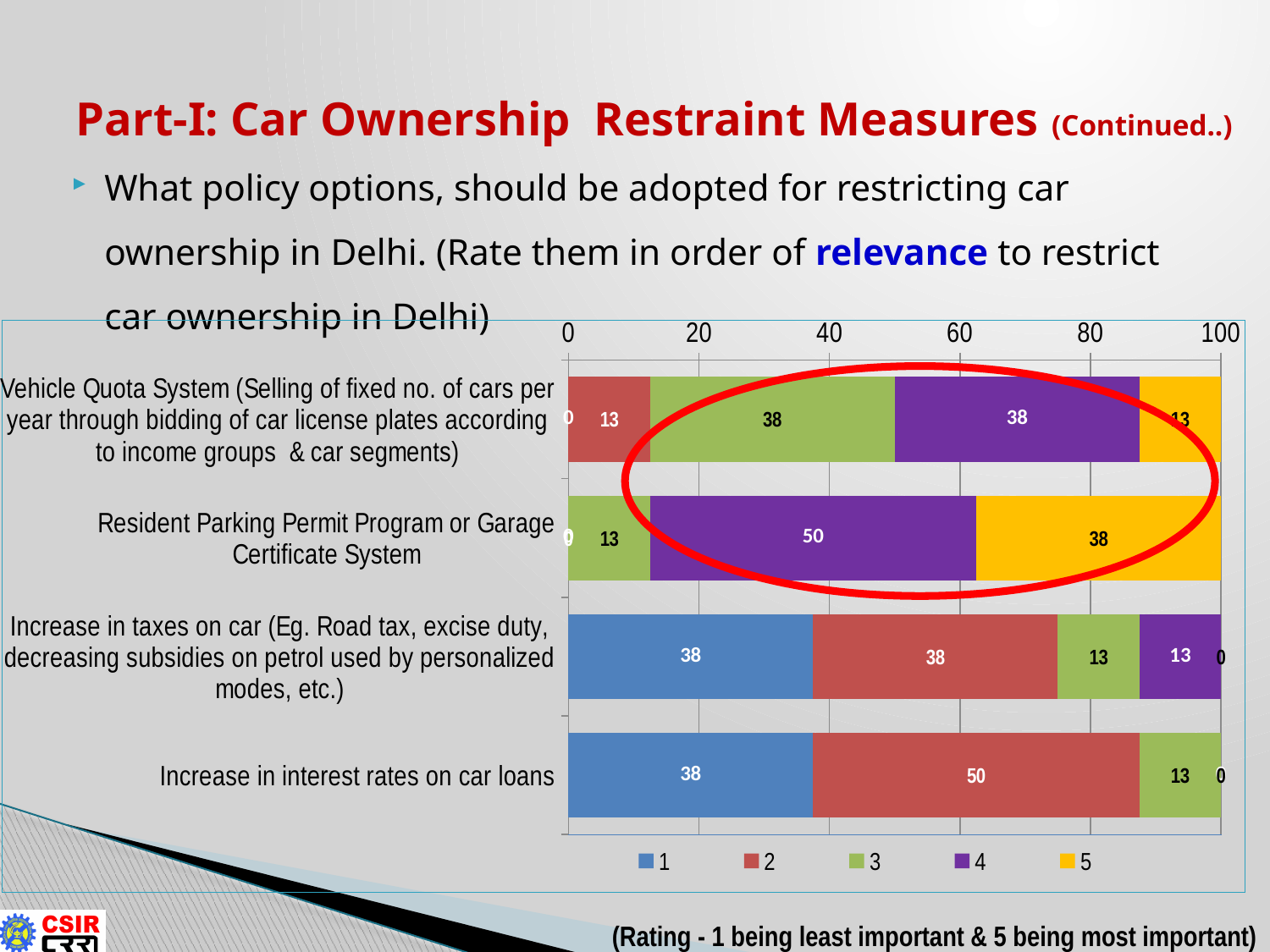
What is the value for rating 2 for 'Increase in interest rates on car loans'? 50 For 'Increase in interest rates on car loans', which is larger: the value for rating 1 or rating 2? rating 2 What is the difference between the rating 4 value and the rating 3 value for 'Resident Parking Permit Program or Garage Certificate System'? 37 Which colour represents rating 5 in the legend? yellow What is the value for rating 4 for 'Resident Parking Permit Program or Garage Certificate System'? 50 What kind of chart is shown on the slide? bar chart What is the value for rating 1 for 'Increase in taxes on car'? 38 How many policy options (categories) are plotted in the chart? 4 How many series does the legend list? 5 What is the value for rating 5 for 'Resident Parking Permit Program or Garage Certificate System'? 38 Which rating has the highest value for 'Resident Parking Permit Program or Garage Certificate System'? 4 What is the value for rating 3 for 'Vehicle Quota System'? 38